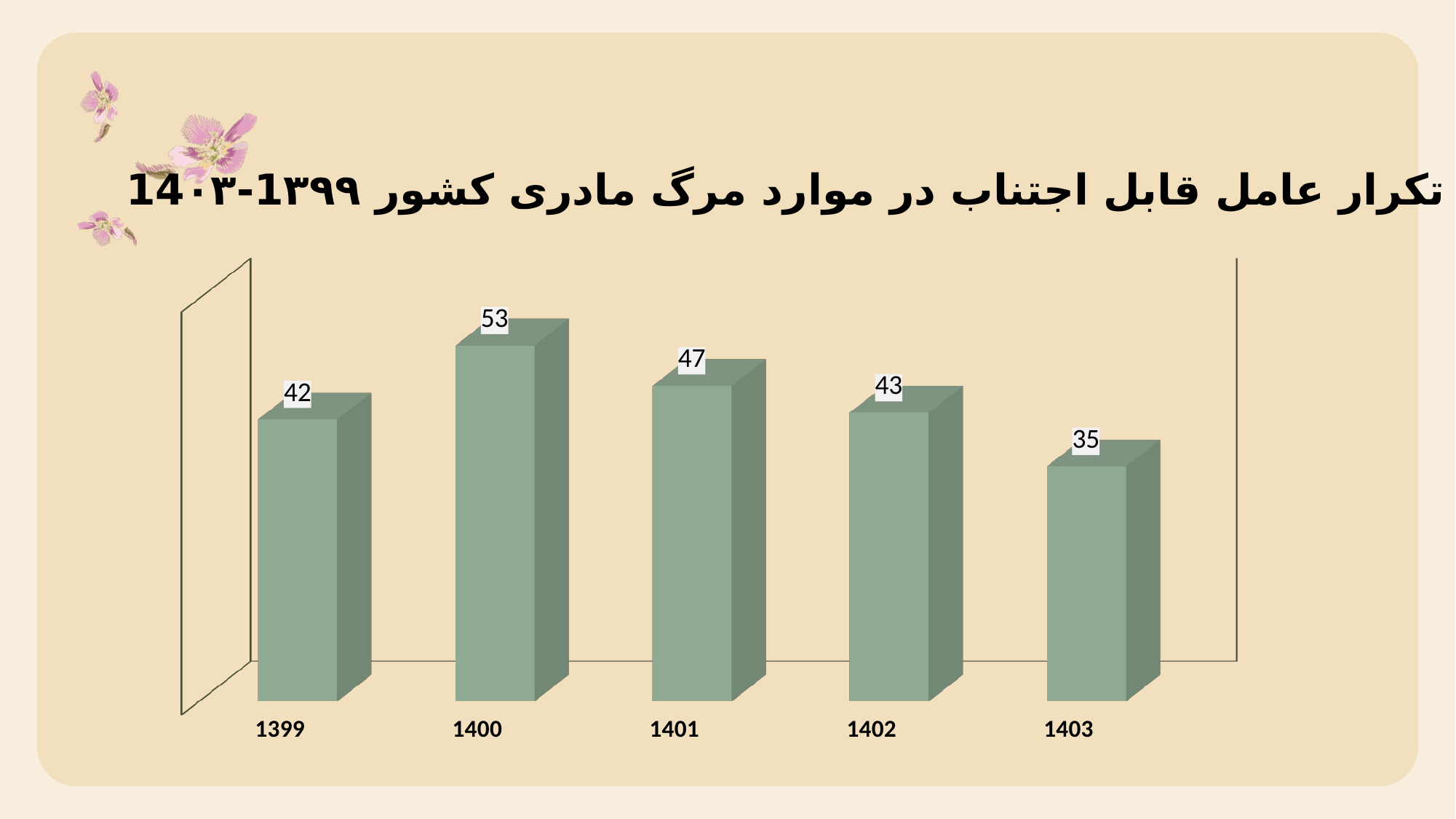
Which year has the highest value? 1400 What is the value for 1400? 53 What is the value for 1401? 47 How many years are shown on the x axis? 5 What is the value for 1403? 35 Which is larger, the value for 1399 or the value for 1402? 1402 What is the difference between the values for 1400 and 1403? 18 Which year has the lowest value? 1403 Do the values rise or fall from 1400 to 1403? fall What kind of chart is shown on the slide? bar chart What is the difference between the values for 1401 and 1402? 4 What is the value for 1399? 42